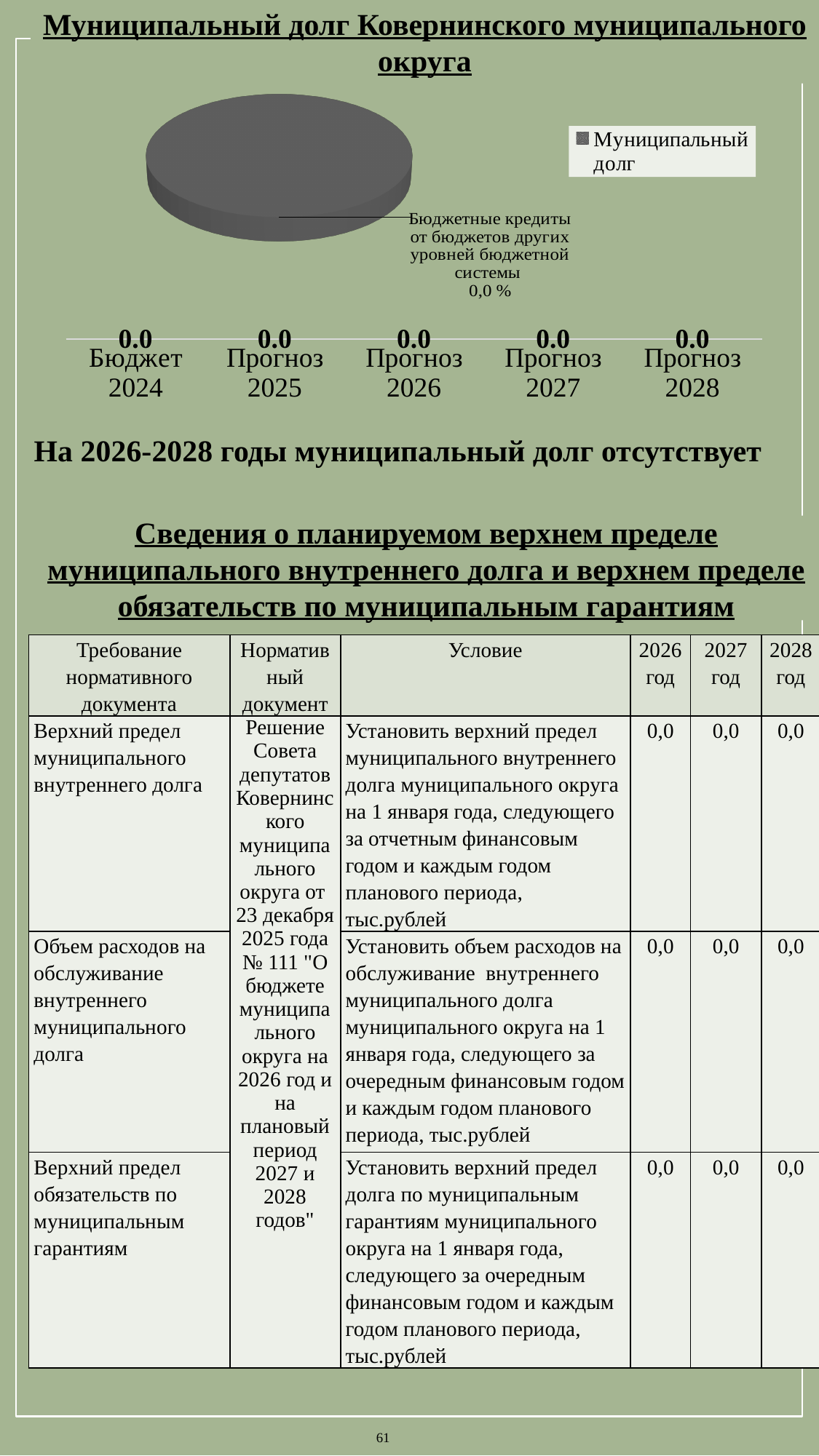
In the top pie chart, how many slices have a data label? 1 In the bar chart below the pie chart, what value is shown for Прогноз 2028? 0.0 In the bar chart below the pie chart, how many categories are shown on the x axis? 5 In the bar chart below the pie chart, what value is shown for Прогноз 2026? 0.0 In the bar chart below the pie chart, do the values rise, fall or stay the same from Бюджет 2024 to Прогноз 2028? stay the same What kind of chart is the top chart on the slide? pie chart In the bar chart below the pie chart, what is the label of the first category on the x axis? Бюджет 2024 In the top pie chart, what percentage is shown for the slice labelled Бюджетные кредиты от бюджетов других уровней бюджетной системы? 0,0 % In the bar chart below the pie chart, what value is shown for Бюджет 2024? 0.0 In the top pie chart, what is the legend entry? Муниципальный долг In the top pie chart, how many entries does the legend list? 1 In the bar chart below the pie chart, what is the difference between the values for Прогноз 2025 and Прогноз 2027? 0.0